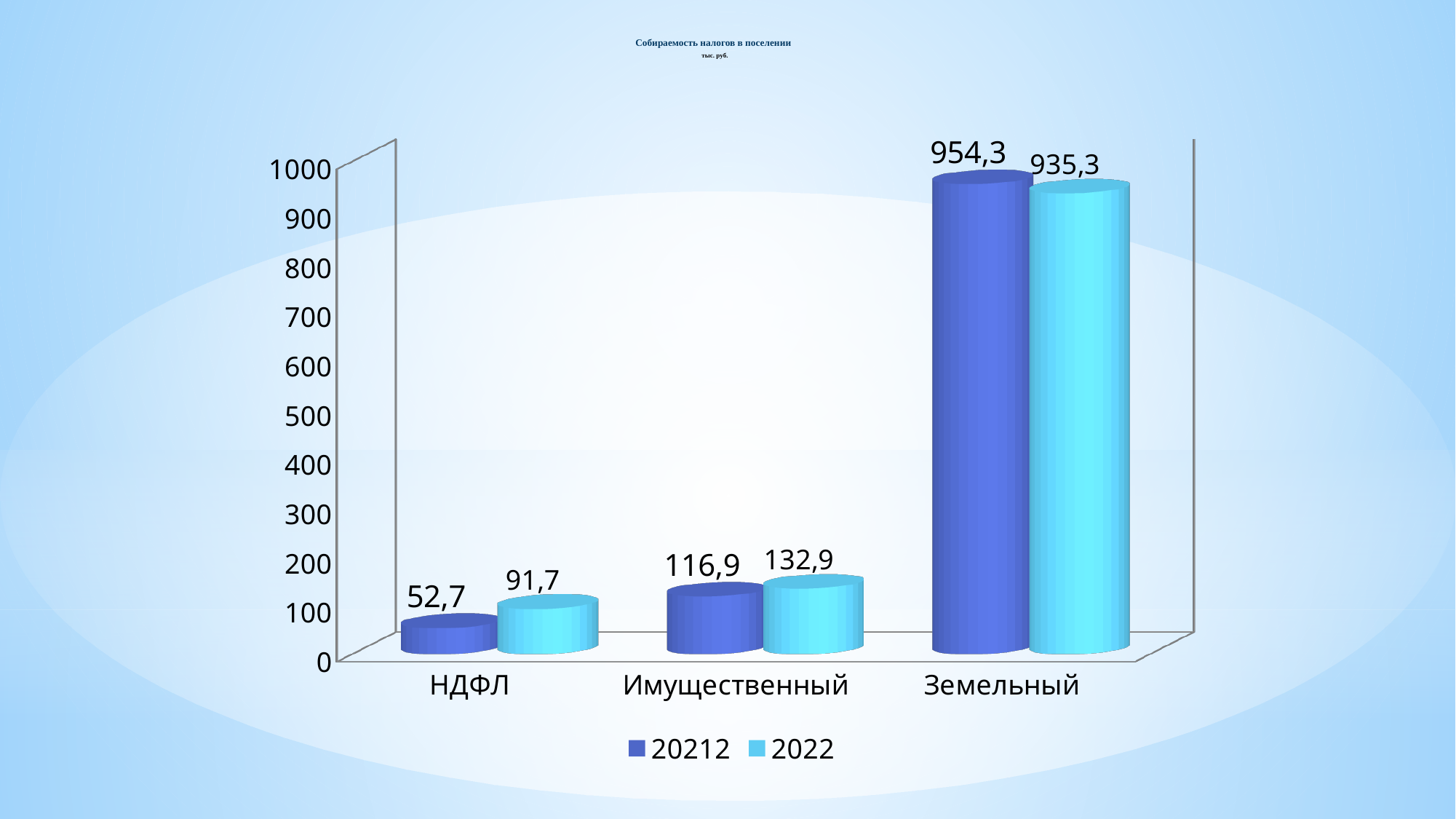
How many categories are shown on the x axis? 3 What is the value for Имущественный in the 2022 series? 132,9 What is the difference between the 20212 and 2022 values for Земельный? 19 How many series does the legend list? 2 For Имущественный, which series has the larger value, 20212 or 2022? 2022 What is the value for Земельный in the 2022 series? 935,3 What is the difference between the 2022 and 20212 values for НДФЛ? 39 Which category has the highest value in the 20212 series? Земельный Which category has the lowest value in the 2022 series? НДФЛ What unit is given under the chart title? тыс. руб. What kind of chart is shown on the slide? Bar chart What is the value for НДФЛ in the 20212 series? 52,7